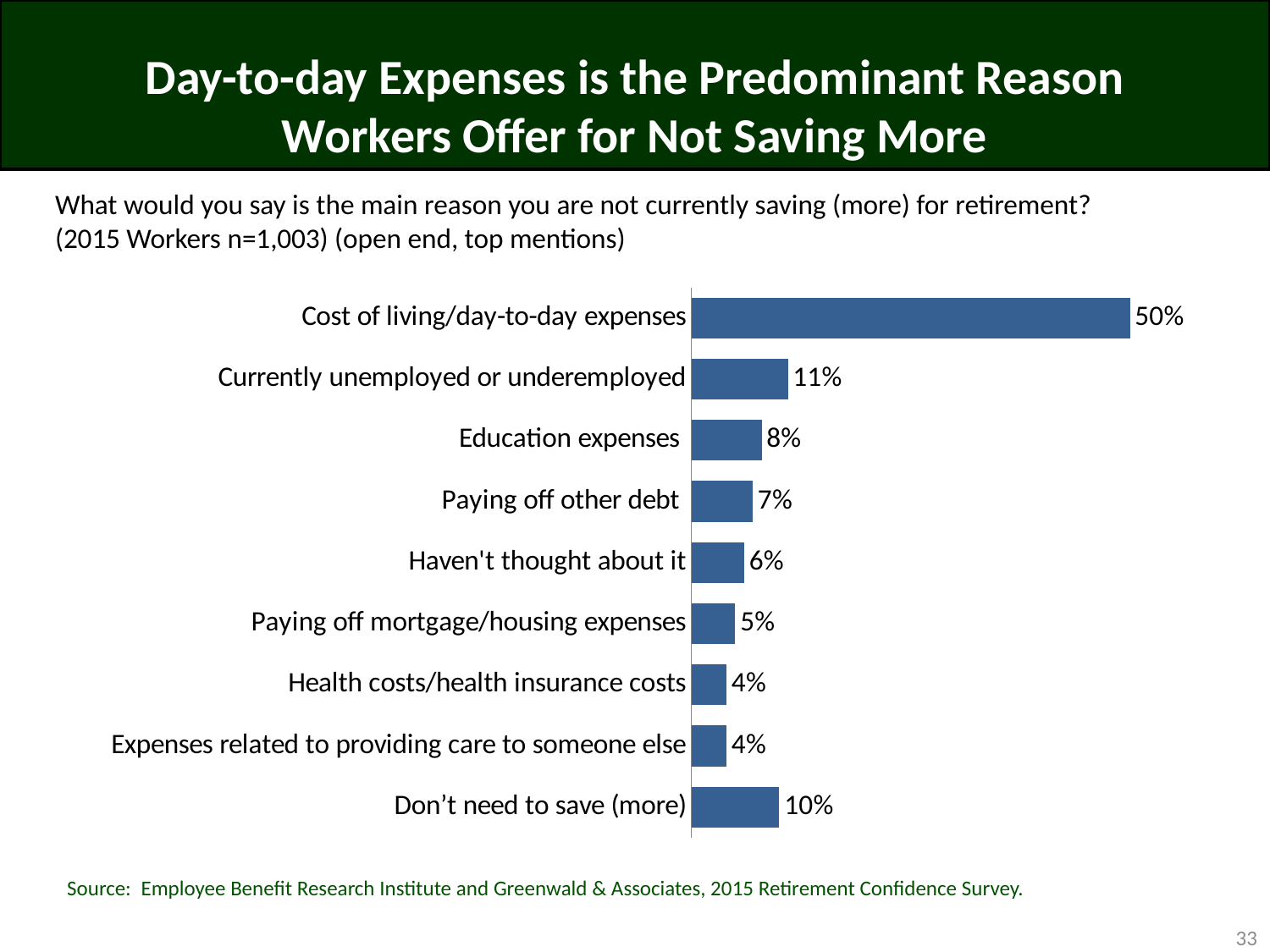
What is the difference between the values for 'Cost of living/day-to-day expenses' and 'Currently unemployed or underemployed'? 39% What is the difference between 'Education expenses' and 'Paying off other debt'? 1% Which is larger: the value for 'Don't need to save (more)' or the value for 'Education expenses'? Don't need to save (more) What is the value for 'Currently unemployed or underemployed'? 11% What percentage of workers said they don't need to save (more)? 10% How many reasons (categories) are shown in the chart? 9 What percentage of workers cited cost of living/day-to-day expenses as the main reason for not saving more? 50% Which two reasons share the same value of 4%? Health costs/health insurance costs and Expenses related to providing care to someone else What kind of chart is shown on the slide? Bar chart What is the sample size of workers shown in the chart's subtitle? n=1,003 What is the value for 'Paying off mortgage/housing expenses'? 5% Which reason has the highest percentage? Cost of living/day-to-day expenses